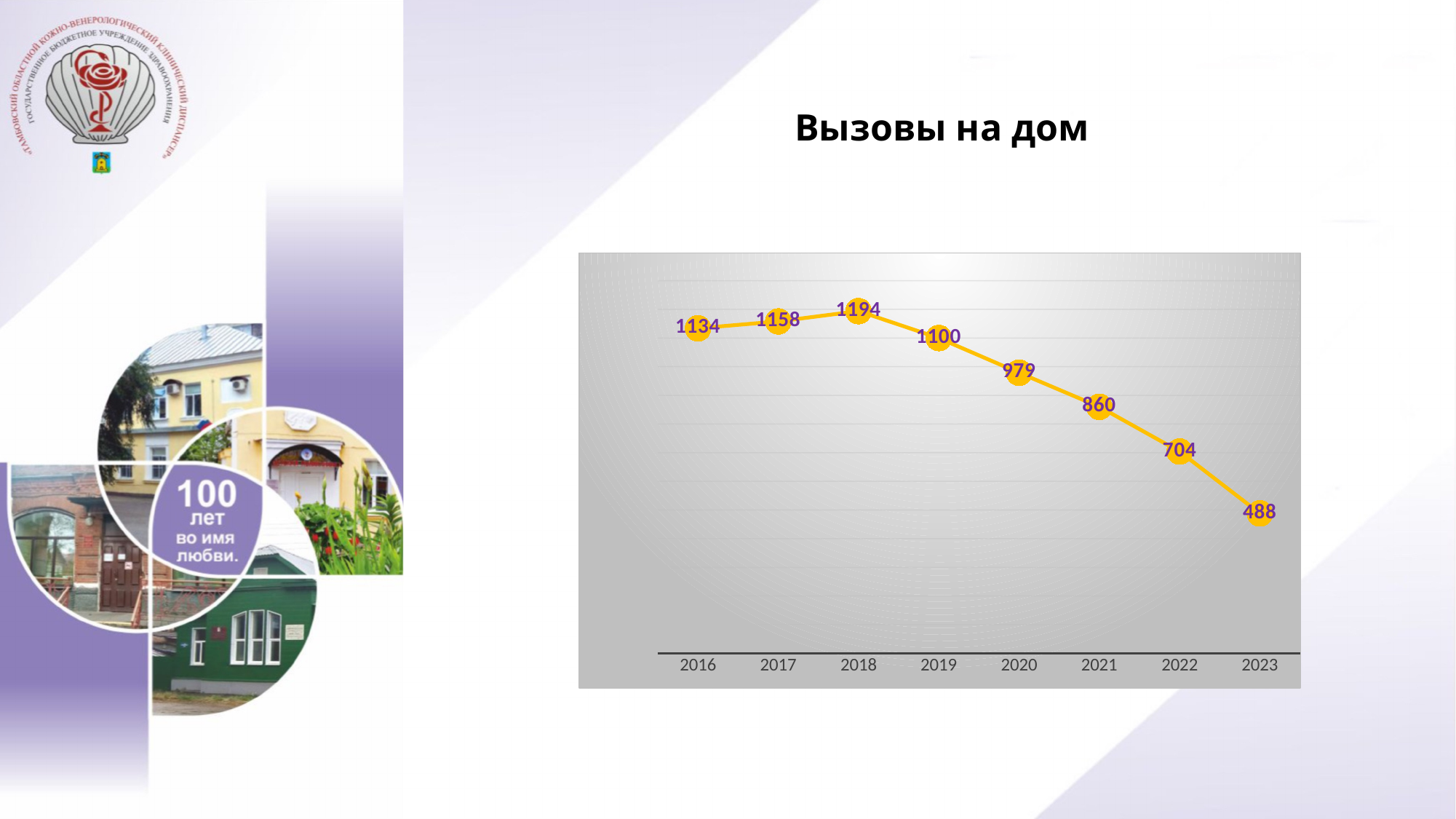
Which is larger, the value for 2017 or the value for 2022? 2017 Do the values rise or fall from 2018 to 2023? fall How many years are plotted on the chart? 8 What is the value for 2023? 488 What is the value for 2016? 1134 What is the value for 2019? 1100 What is the title of the chart? Вызовы на дом Which year has the lowest value? 2023 What is the difference between the values for 2020 and 2021? 119 What is the difference between the values for 2018 and 2023? 706 What kind of chart is shown on the slide? line chart Which year has the highest value? 2018